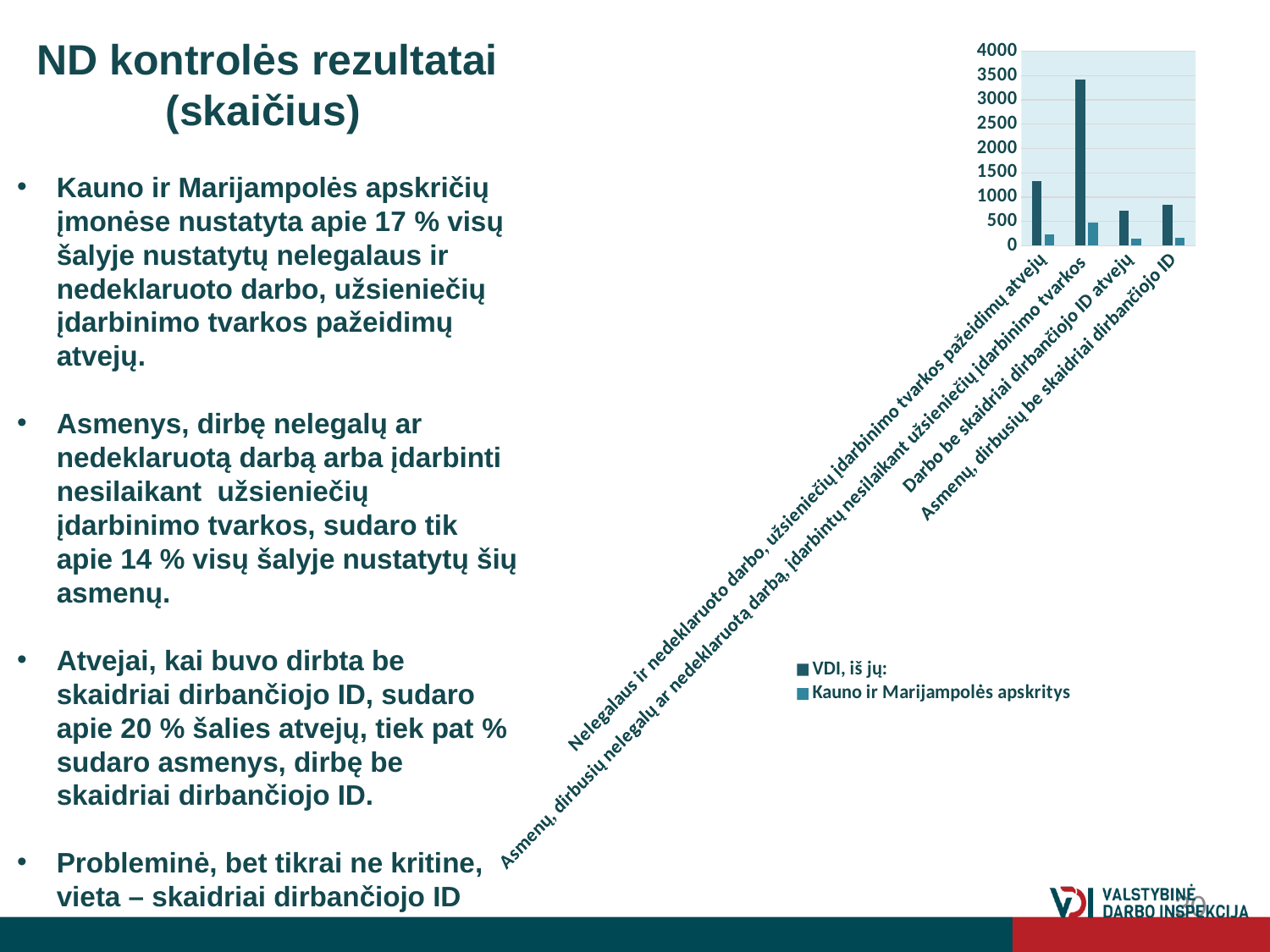
How many categories are plotted on the x axis of the chart? 4 Is the 'Kauno ir Marijampolės apskritys' value for 'Nelegalaus ir nedeklaruoto darbo, užsieniečių įdarbinimo tvarkos pažeidimų atvejų' greater or less than 500? less Is the 'VDI, iš jų:' value for 'Asmenų, dirbusių nelegalų ar nedeklaruotą darbą, įdarbintų nesilaikant užsieniečių įdarbinimo tvarkos' greater or less than 3000? greater Is the 'VDI, iš jų:' value for 'Nelegalaus ir nedeklaruoto darbo, užsieniečių įdarbinimo tvarkos pažeidimų atvejų' greater or less than 1000? greater How many series does the chart legend list? 2 What kind of chart is shown on the slide? bar chart For the 'VDI, iš jų:' series, which is larger: 'Nelegalaus ir nedeklaruoto darbo, užsieniečių įdarbinimo tvarkos pažeidimų atvejų' or 'Darbo be skaidriai dirbančiojo ID atvejų'? Nelegalaus ir nedeklaruoto darbo, užsieniečių įdarbinimo tvarkos pažeidimų atvejų Which category has the highest value for the 'VDI, iš jų:' series? Asmenų, dirbusių nelegalų ar nedeklaruotą darbą, įdarbintų nesilaikant užsieniečių įdarbinimo tvarkos In every category, which series has the taller bar? VDI, iš jų: What is the maximum value shown on the chart's vertical axis? 4000